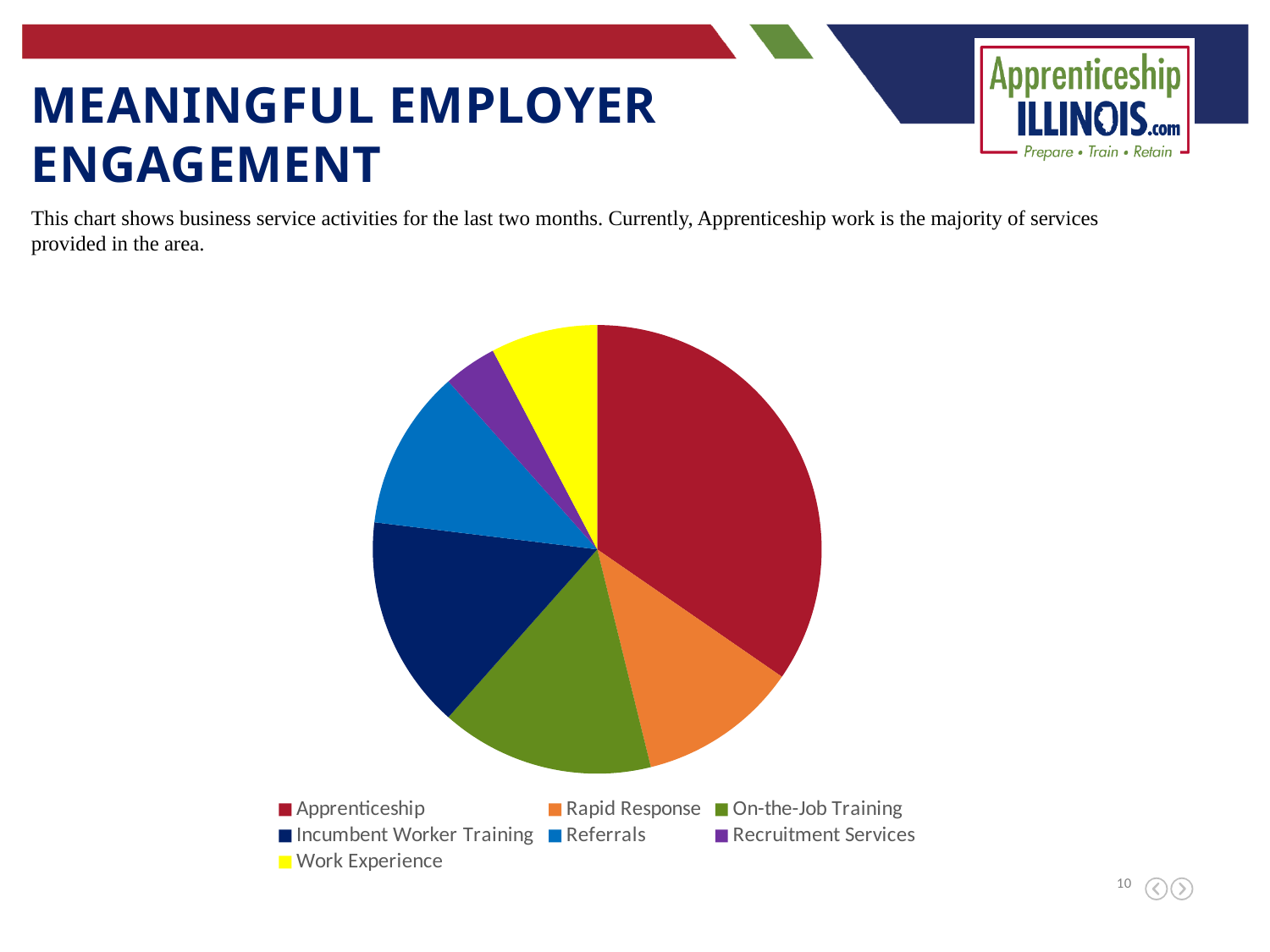
What colour is the Work Experience slice in the pie chart? yellow Which slice is larger, Apprenticeship or Rapid Response? Apprenticeship What kind of chart is shown on the slide? pie chart Which category has the smallest slice of the pie chart? Recruitment Services Which slice is larger, Apprenticeship or On-the-Job Training? Apprenticeship Which slice is larger, Work Experience or Recruitment Services? Work Experience What colour is the Apprenticeship slice in the pie chart? dark red Which category has the largest slice of the pie chart? Apprenticeship How many entries does the legend of the pie chart list? 7 How many categories (slices) does the pie chart have? 7